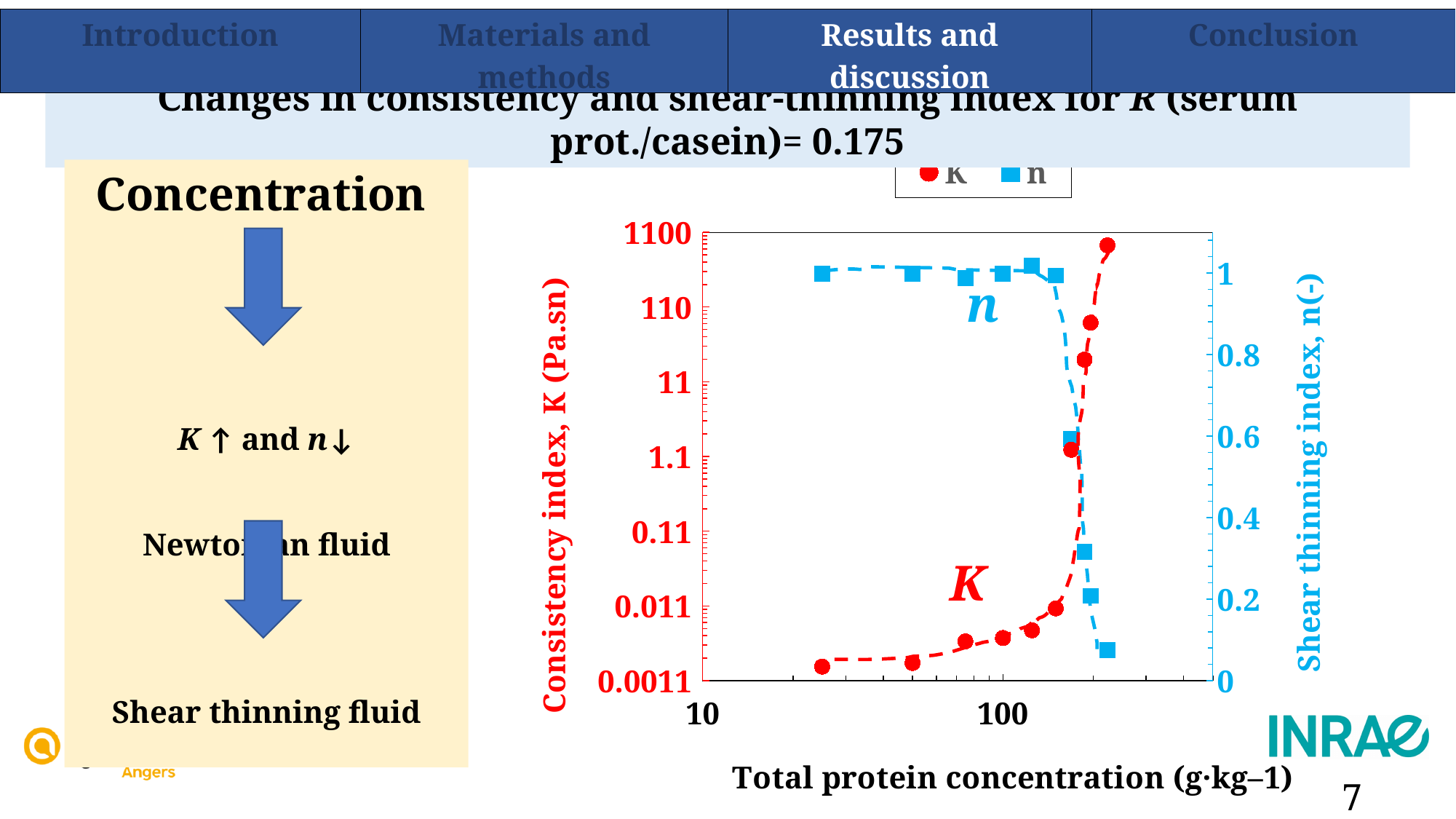
Is the value of n at the highest protein concentration greater or less than 0.2? less Which is larger: the value of n at the lowest protein concentration or at the highest protein concentration? At the lowest protein concentration How many series does the chart's legend list? 2 Is the value of K at the highest protein concentration greater or less than 110? greater Is the value of n at the lowest protein concentration greater or less than 0.8? greater Does the shear thinning index n rise or fall as total protein concentration increases? Falls What is the title of the chart's x axis? Total protein concentration (g·kg–1) Which is larger: the value of K at the lowest protein concentration or at the highest protein concentration? At the highest protein concentration What are the two series named in the chart's legend? K and n Does the consistency index K rise or fall as total protein concentration increases? Rises What kind of chart is shown on the slide? Scatter chart